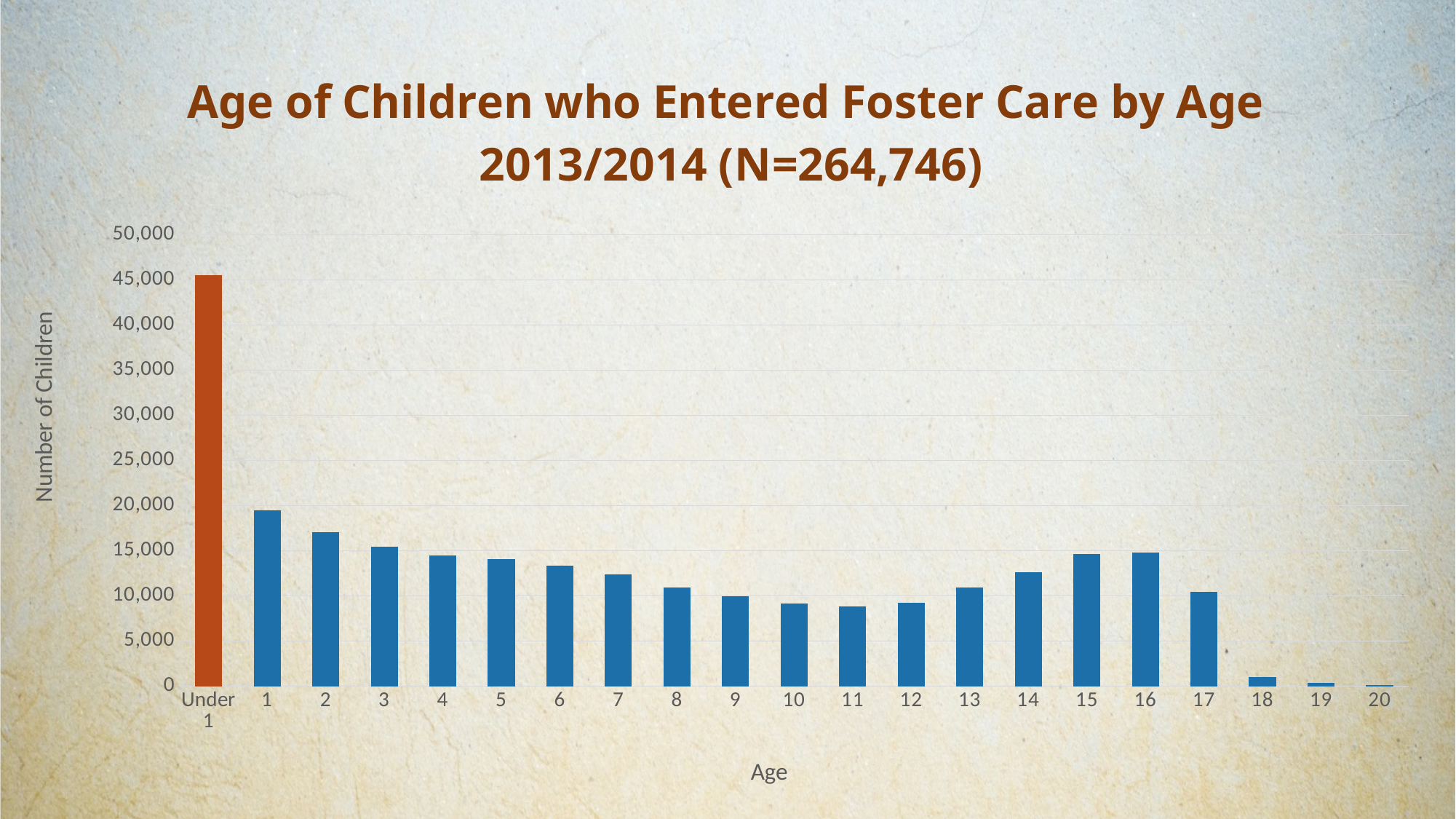
What is the label on the vertical axis? Number of Children Which is larger, the value for age 1 or the value for age 2? Age 1 Do the values rise or fall from age 1 to age 11? Fall Is the value for age 11 greater or less than 10,000? less How many age categories are shown on the x axis? 21 Is the value for age 2 greater or less than 15,000? greater Is the value for Under 1 greater or less than 40,000? greater What kind of chart is shown on the slide? Bar chart Which is larger, the value for age 16 or the value for age 17? Age 16 Which age category has the highest number of children entering foster care? Under 1